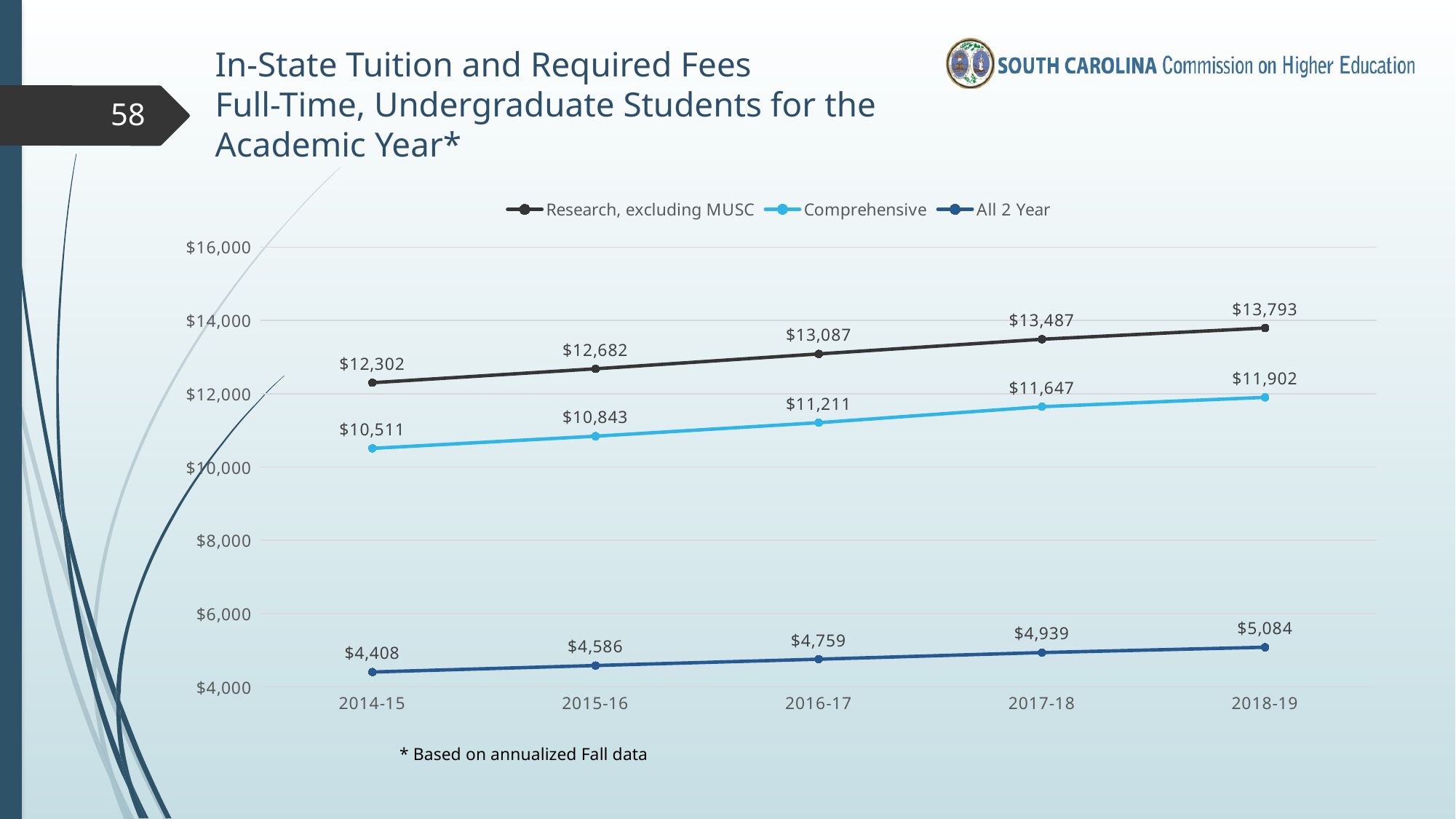
Do the All 2 Year values rise or fall from 2014-15 to 2018-19? rise What is the value for All 2 Year in 2018-19? $5,084 Is the value for Research, excluding MUSC in 2018-19 greater or less than $14,000? less How many series does the legend list? 3 In which academic year is the All 2 Year value lowest? 2014-15 In which academic year is the Comprehensive value highest? 2018-19 What is the value for Research, excluding MUSC in 2014-15? $12,302 What is the value for Comprehensive in 2016-17? $11,211 How many academic years are shown on the x axis? 5 Which is larger in 2017-18: the Comprehensive value or the All 2 Year value? Comprehensive What kind of chart is shown on the slide? line chart What is the difference between the Research, excluding MUSC value and the Comprehensive value in 2018-19? $1,891